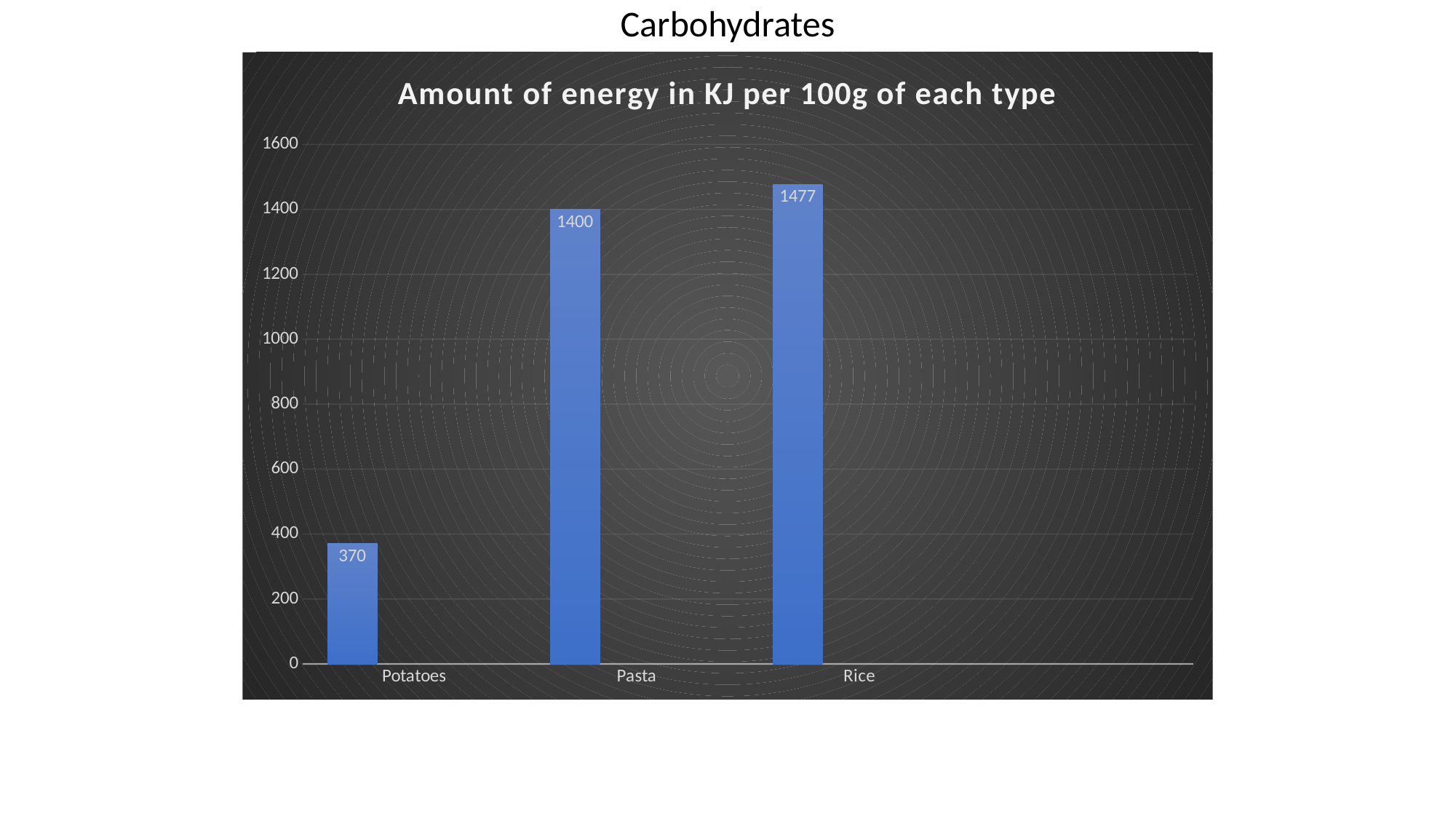
What is the difference between the values for Pasta and Potatoes? 1030 What kind of chart is shown on the slide? bar chart What is the title of the chart? Amount of energy in KJ per 100g of each type What is the value for Potatoes? 370 Which category has the highest value? Rice What is the value for Pasta? 1400 What is the difference between the values for Rice and Pasta? 77 Which category has the lowest value? Potatoes What is the value for Rice? 1477 Which is larger, the value for Potatoes or the value for Pasta? Pasta Is the value for Potatoes greater or less than 400? less How many categories are shown on the x axis? 3